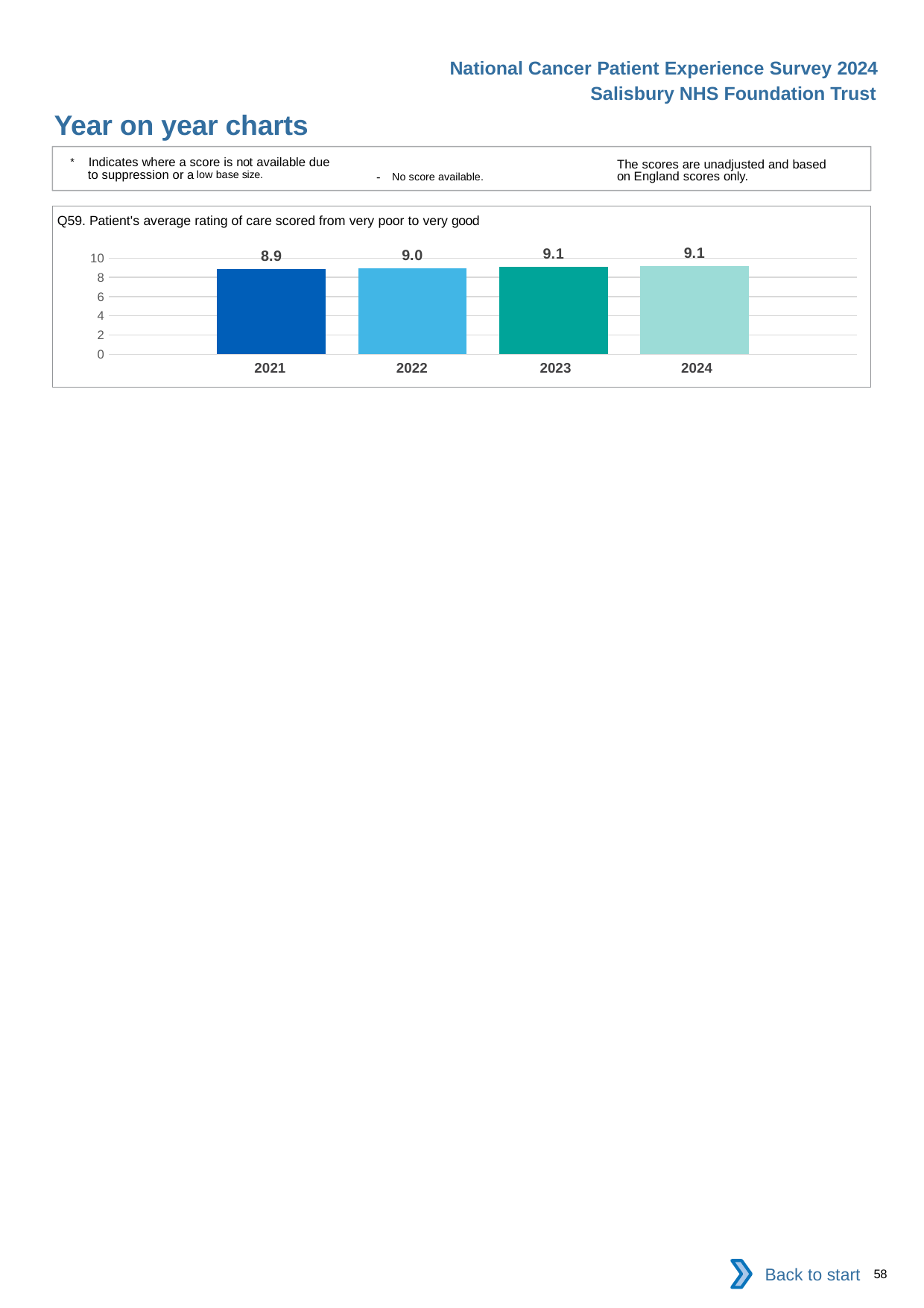
What is the difference between the 2022 and 2021 values in the Q59 chart? 0.1 Which is larger in the Q59 chart, the value for 2021 or the value for 2023? 2023 Is the value for 2022 in the Q59 chart greater or less than 8? greater What is the value for 2022 in the Q59 chart? 9.0 How many years are shown in the Q59 chart? 4 What is the title of the chart on the slide? Q59. Patient's average rating of care scored from very poor to very good Do the values in the Q59 chart rise or fall from 2021 to 2024? rise What is the value for 2024 in the Q59 chart? 9.1 What kind of chart is used for Q59? bar chart Which year has the lowest value in the Q59 chart? 2021 What is the value for 2021 in the Q59 chart? 8.9 What is the difference between the 2023 and 2021 values in the Q59 chart? 0.2